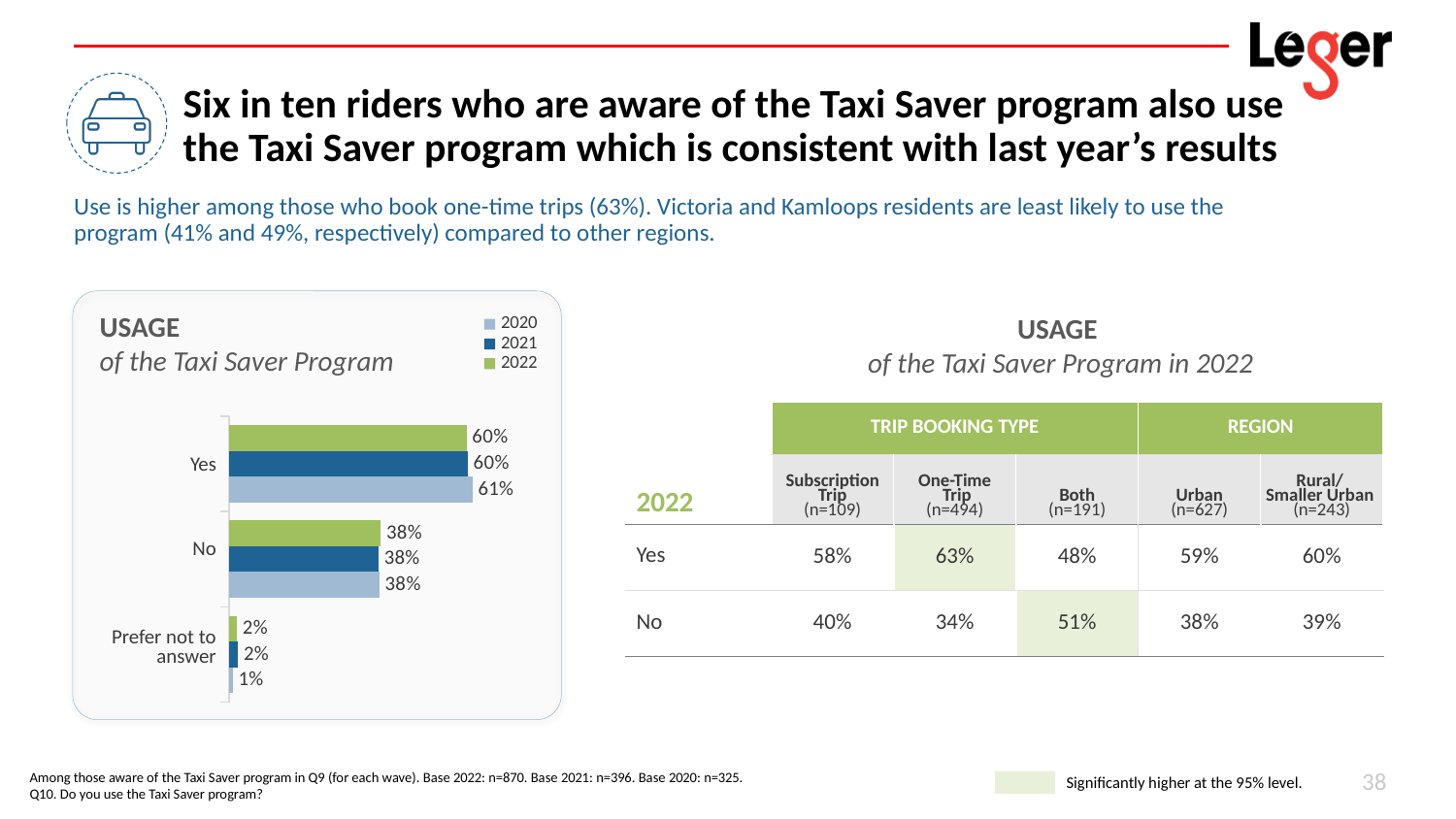
Which year does the green series represent in the Usage of the Taxi Saver Program chart? 2022 What is the 2021 value for "No" in the Usage of the Taxi Saver Program chart? 38% In the Usage of the Taxi Saver Program chart, is the 2020 value for "Yes" larger or smaller than the 2020 value for "No"? larger What is the 2020 value for "Yes" in the Usage of the Taxi Saver Program chart? 61% Which category has the lowest 2021 value in the Usage of the Taxi Saver Program chart? Prefer not to answer What type of chart is the Usage of the Taxi Saver Program chart? bar chart What is the difference between the 2022 values for "Yes" and "No" in the Usage of the Taxi Saver Program chart? 22% What is the 2022 value for "Yes" in the Usage of the Taxi Saver Program chart? 60% How many categories are shown in the Usage of the Taxi Saver Program chart? 3 What is the 2020 value for "Prefer not to answer" in the Usage of the Taxi Saver Program chart? 1% How many series does the legend of the Usage of the Taxi Saver Program chart list? 3 Which category has the highest 2022 value in the Usage of the Taxi Saver Program chart? Yes